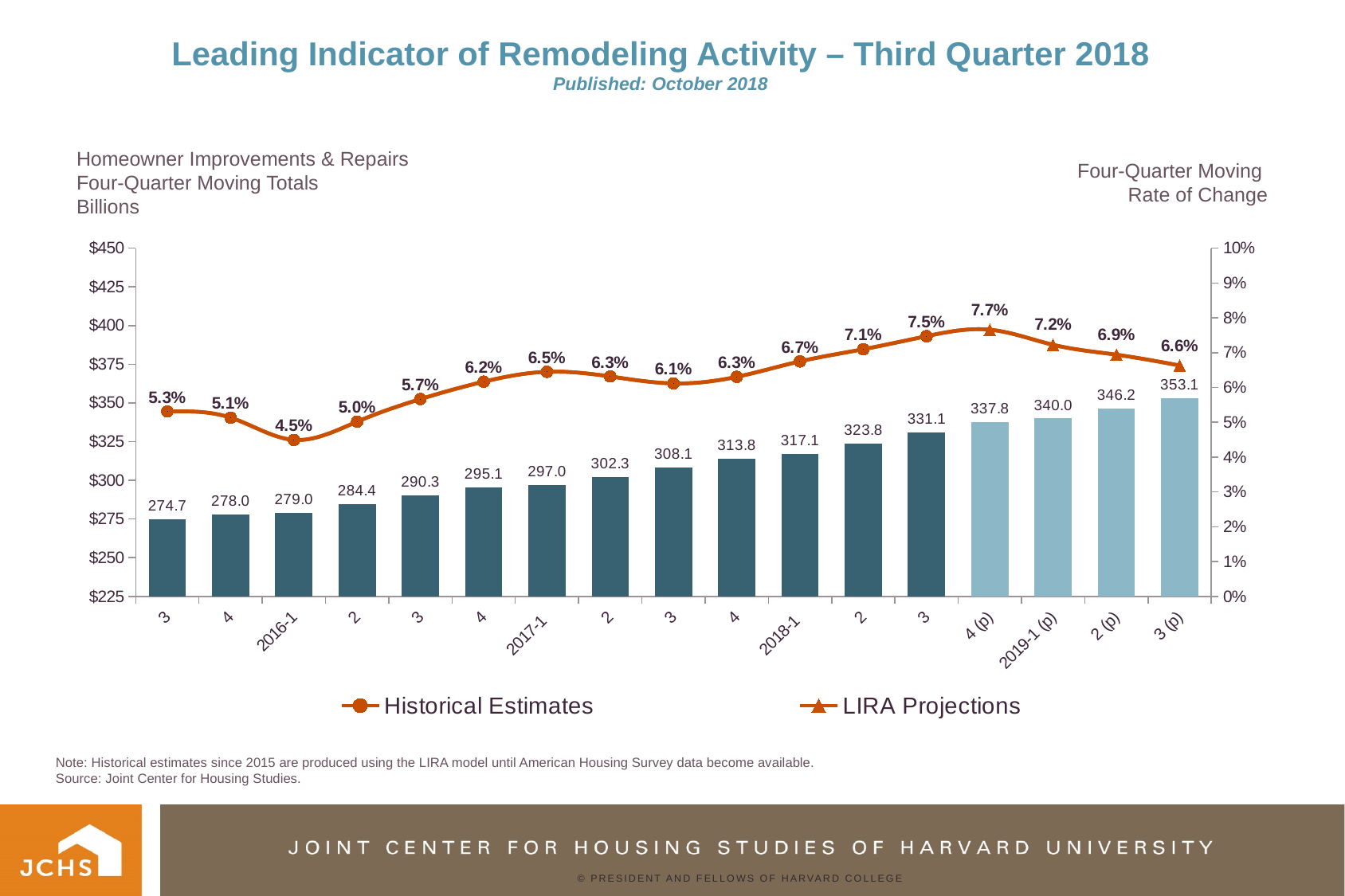
What is the difference between the last bar, 3 (p), and the first bar, 274.7? 78.4 Which period has the lowest four-quarter moving rate of change on the line? 2016-1 By how many percentage points does the rate of change fall from its peak of 7.7% to the final point at 3 (p)? 1.1 What is the four-quarter moving total for 2018-1? 317.1 What is the four-quarter moving rate of change shown for 2017-1? 6.5% Which period has the highest four-quarter moving rate of change on the line? 4 (p) What kind of chart is this? Combination bar and line chart Do the four-quarter moving total bars rise or fall from left to right? Rise What is the projected four-quarter moving total for 2019-1 (p)? 340.0 How many bars are plotted in the chart? 17 Which is larger, the four-quarter moving total for 2018-1 or for 2017-1? 2018-1 How many series does the legend list? 2